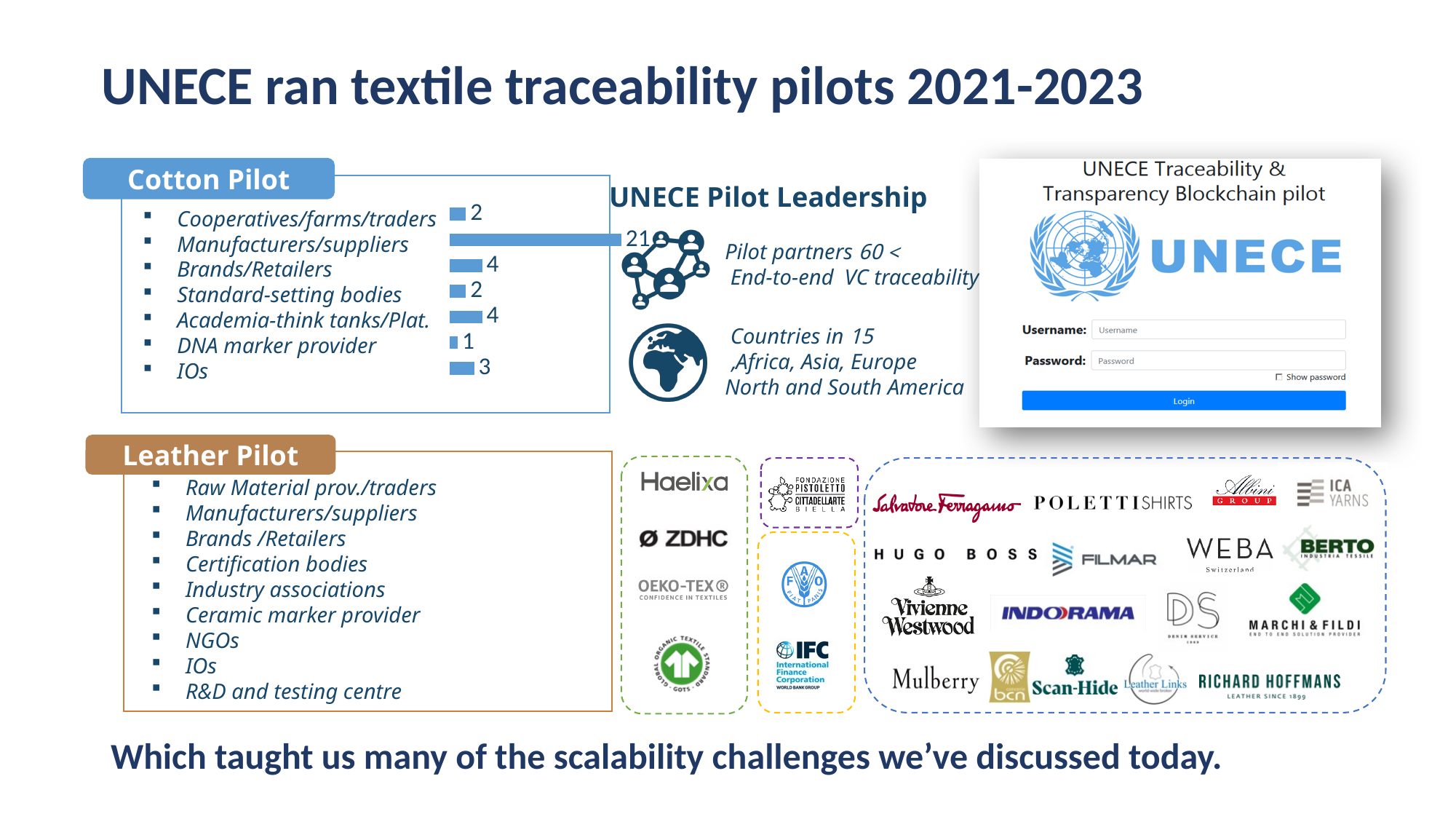
In the Cotton Pilot chart, which is larger: the value for IOs or the value for Standard-setting bodies? IOs What kind of chart is shown in the Cotton Pilot box? Bar chart In the Cotton Pilot chart, what is the difference between the values for Manufacturers/suppliers and Brands/Retailers? 17 In the Cotton Pilot chart, what is the total of the values for Brands/Retailers and Academia-think tanks/Plat.? 8 In the Cotton Pilot chart, which category has the lowest value? DNA marker provider In the Cotton Pilot chart, what is the value for Manufacturers/suppliers? 21 In the Cotton Pilot chart, what is the value for DNA marker provider? 1 How many categories are shown in the Cotton Pilot chart? 7 In the Cotton Pilot chart, what is the value for Cooperatives/farms/traders? 2 In the Cotton Pilot chart, what is the value for IOs? 3 In the Cotton Pilot chart, what is the value for Brands/Retailers? 4 In the Cotton Pilot chart, which category has the highest value? Manufacturers/suppliers